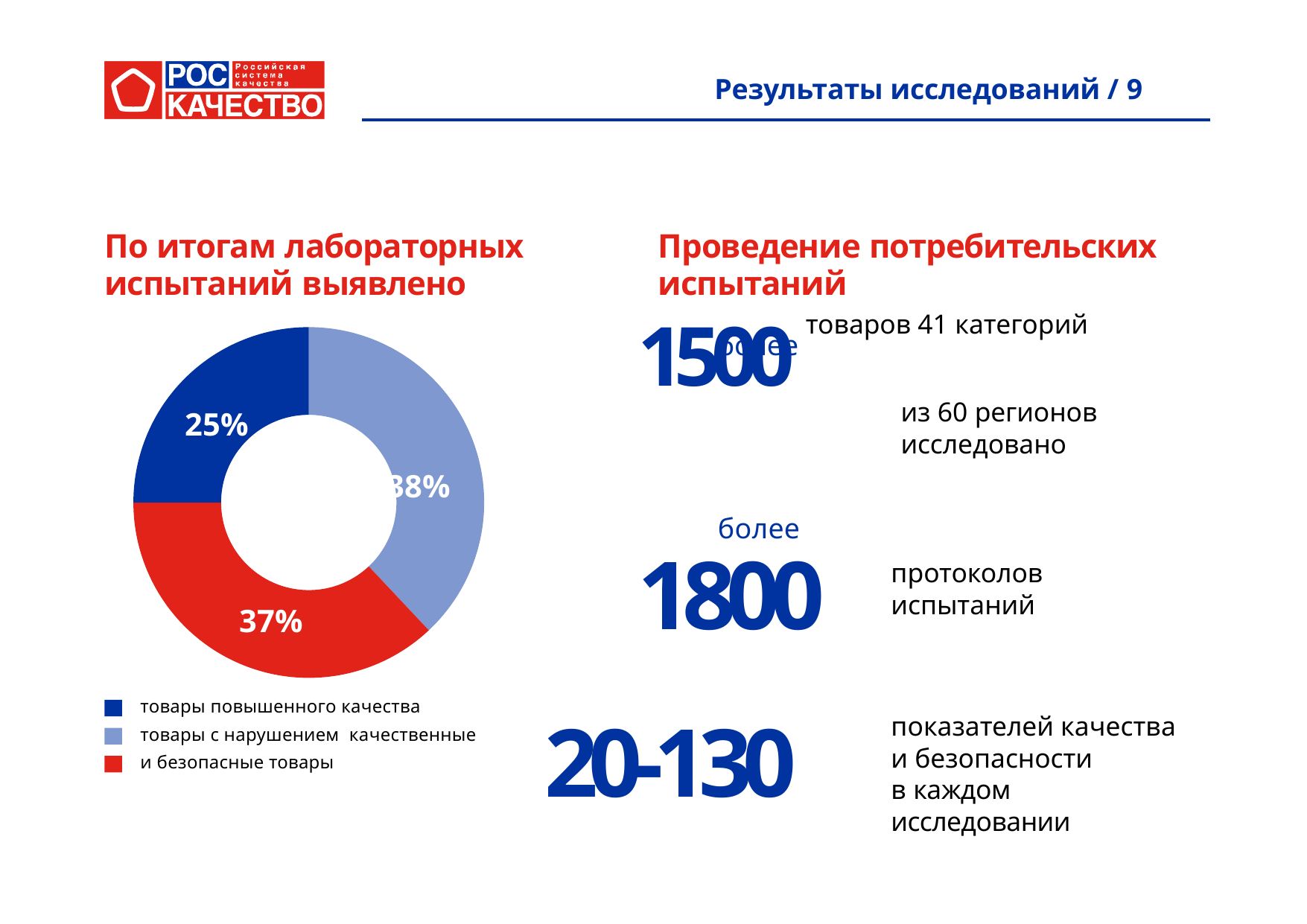
Is the share for товары повышенного качества greater or less than 30%? less What kind of chart is shown on the left of the slide? Pie (donut) chart Which slice is larger: товары повышенного качества or качественные и безопасные товары? качественные и безопасные товары What is the title above the donut chart? По итогам лабораторных испытаний выявлено What share of the donut chart is labelled for качественные и безопасные товары (red)? 37% Which category has the smallest slice in the donut chart? товары повышенного качества By how many percentage points does the red slice (37%) exceed the dark blue slice (25%)? 12 percentage points How many slices does the donut chart have? 3 What share of the donut chart is labelled for товары с нарушением (light blue)? 38% What colour is the slice for товары повышенного качества in the donut chart? Dark blue By how many percentage points does the light blue slice (38%) exceed the dark blue slice (25%)? 13 percentage points What share of the donut chart is labelled for товары повышенного качества (dark blue)? 25%